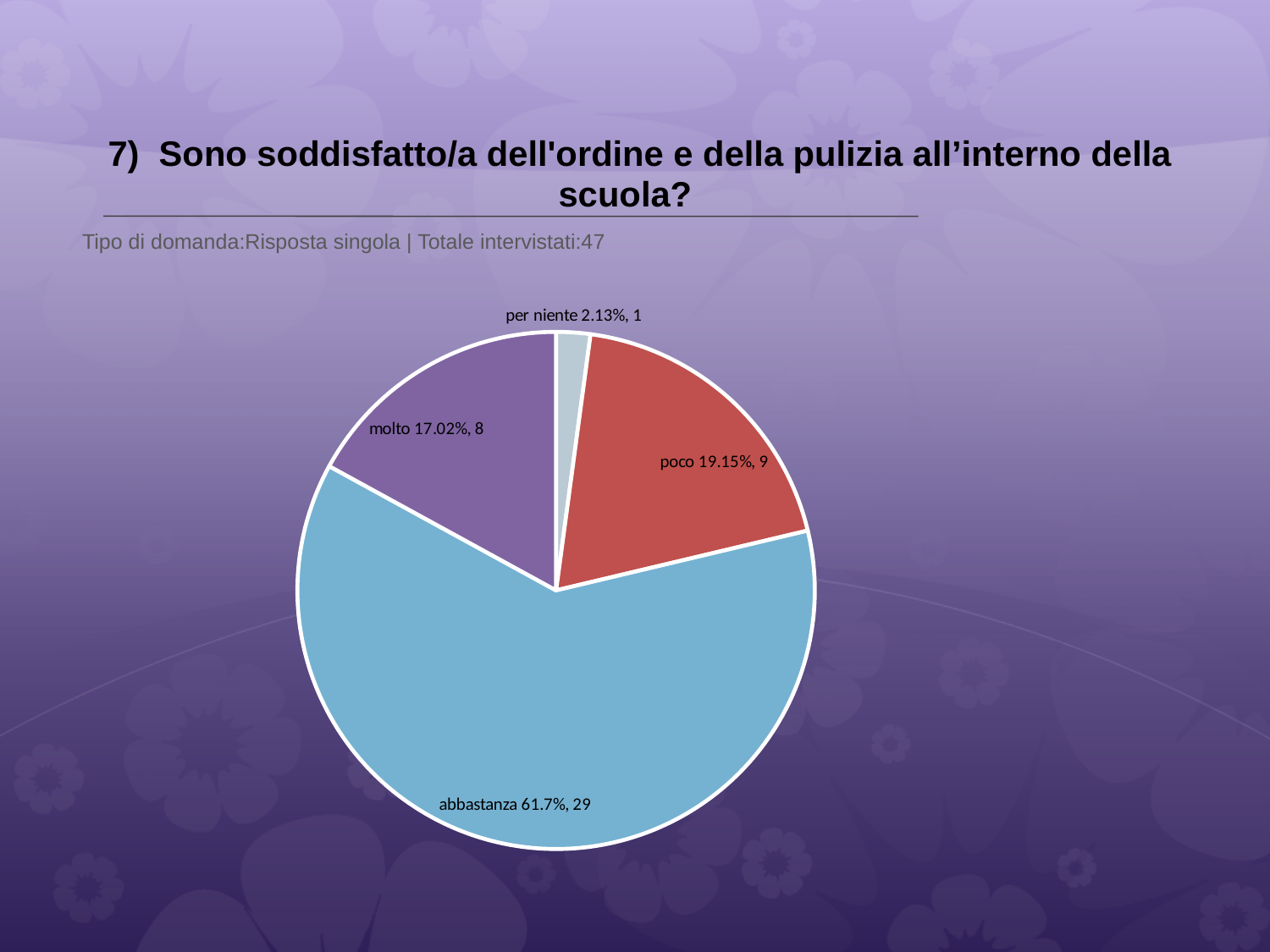
What percentage is shown for the 'molto' slice? 17.02% How many respondents answered 'per niente'? 1 How many slices does the pie chart have? 4 What percentage is shown for the 'abbastanza' slice? 61.7% What kind of chart is shown on the slide? pie chart What is the total number of respondents across all slices? 47 What is the difference in respondent count between 'abbastanza' and 'poco'? 20 How many respondents answered 'poco'? 9 Which has more respondents, 'poco' or 'molto'? poco What colour is the 'abbastanza' slice? light blue Which category has the largest slice of the pie? abbastanza Which category has the smallest slice of the pie? per niente